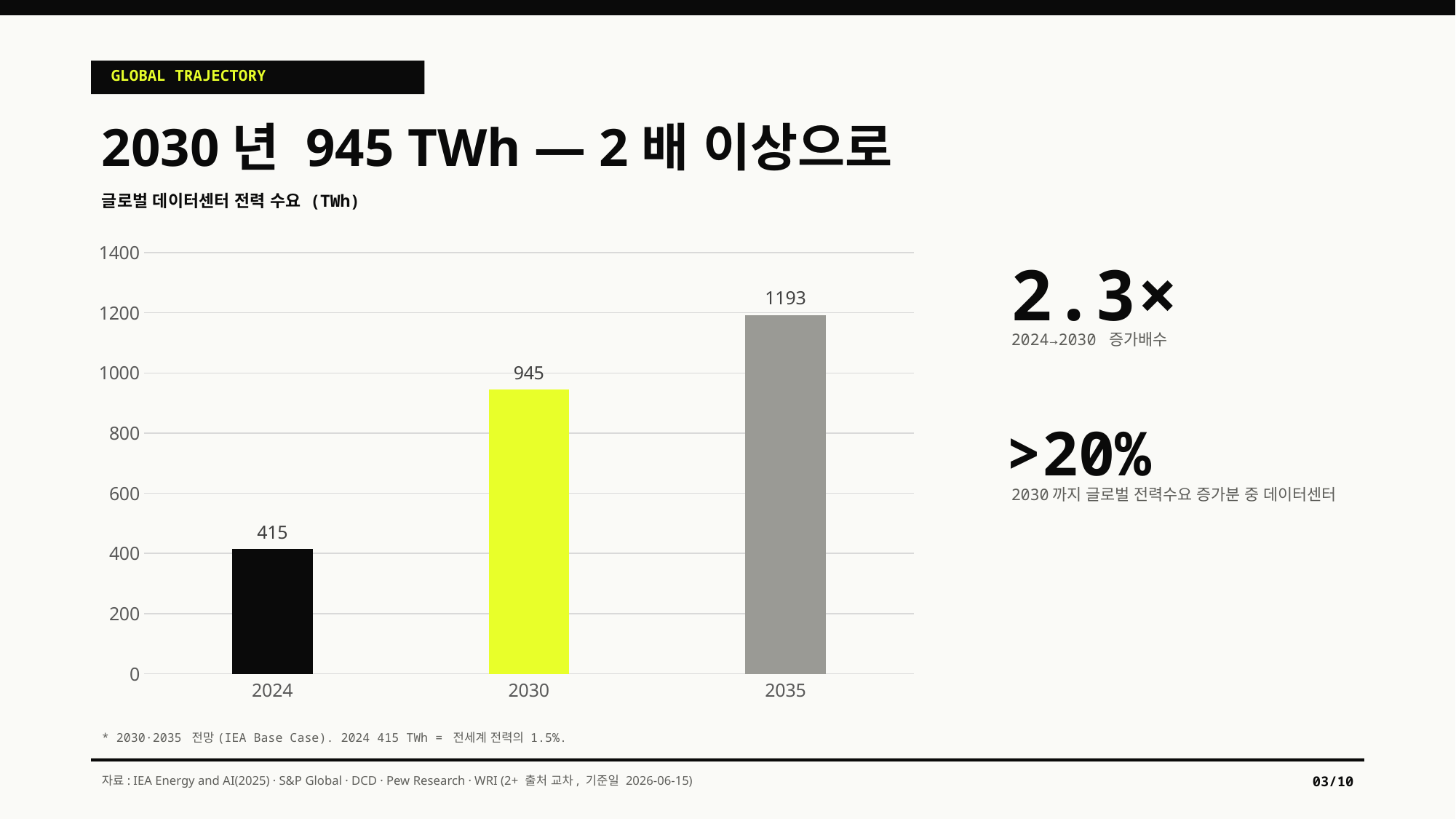
Do the values rise or fall from 2024 to 2035? rise What kind of chart is shown? bar chart Which year has the highest value? 2035 What is the value for 2030? 945 Which year has the lowest value? 2024 Which is larger, the value for 2024 or the value for 2030? 2030 What is the value for 2024? 415 What is the difference between the values for 2030 and 2024? 530 What is the value for 2035? 1193 What is the difference between the values for 2035 and 2030? 248 Is the value for 2035 greater or less than 1000? greater How many years are shown on the x axis? 3